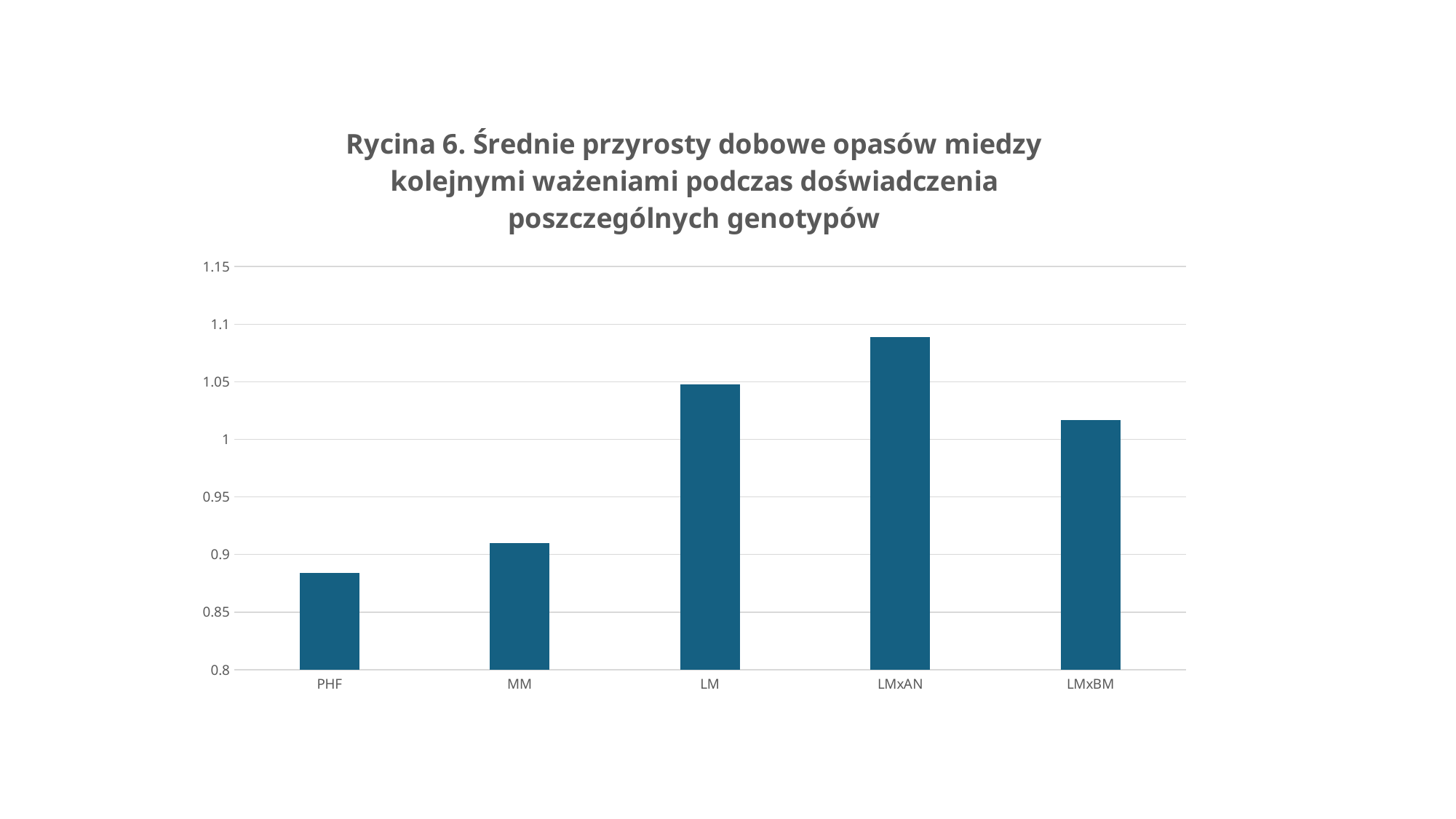
What is the lowest value shown on the y axis? 0.8 What figure number is given in the chart title? Rycina 6 Which genotype has the lowest average daily gain? PHF Is the value for PHF greater or less than 0.9? less Is the value for MM greater or less than 0.95? less Which genotype has the highest average daily gain? LMxAN How many genotypes (categories) are shown on the x axis? 5 Is the value for LMxBM greater or less than 1? greater What kind of chart is shown on the slide? bar chart Which is larger, the value for LM or the value for LMxBM? LM Which is larger, the value for MM or the value for PHF? MM